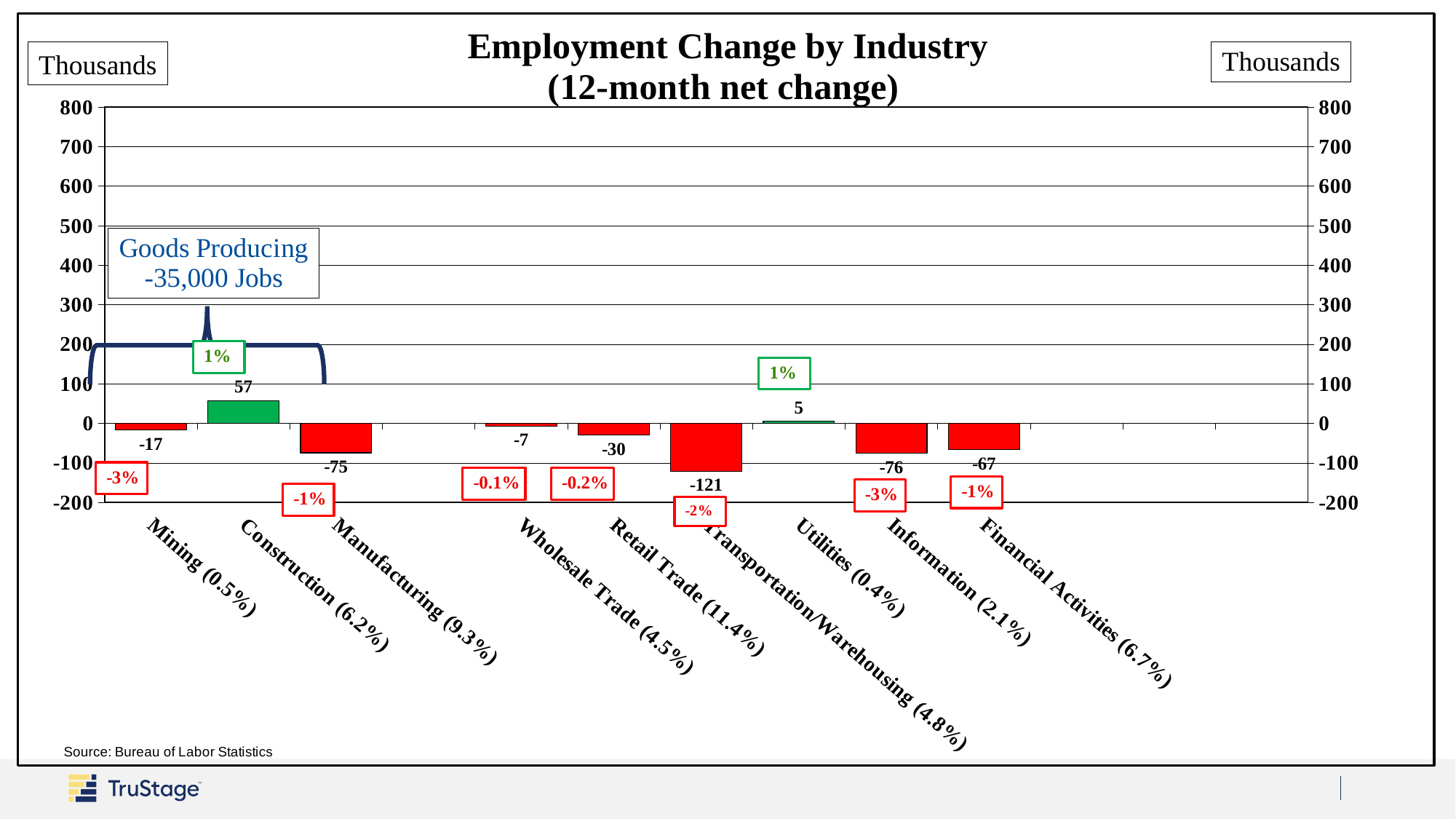
How many industries have labeled bars in the chart? 9 Which industry has the largest positive employment change? Construction What is the 12-month net employment change for Information? -76 According to the callout, how many jobs did the Goods Producing sector lose? -35,000 Jobs Which has a larger employment decline, Retail Trade or Financial Activities? Financial Activities What is the 12-month net employment change for Transportation/Warehousing? -121 What is the 12-month net employment change for Utilities? 5 What is the 12-month net employment change for Construction? 57 What type of chart is shown on the slide? Bar chart Is the value for Transportation/Warehousing greater or less than -100? less Which industry has the largest employment decline? Transportation/Warehousing What is the difference between the employment change for Construction and Manufacturing? 132